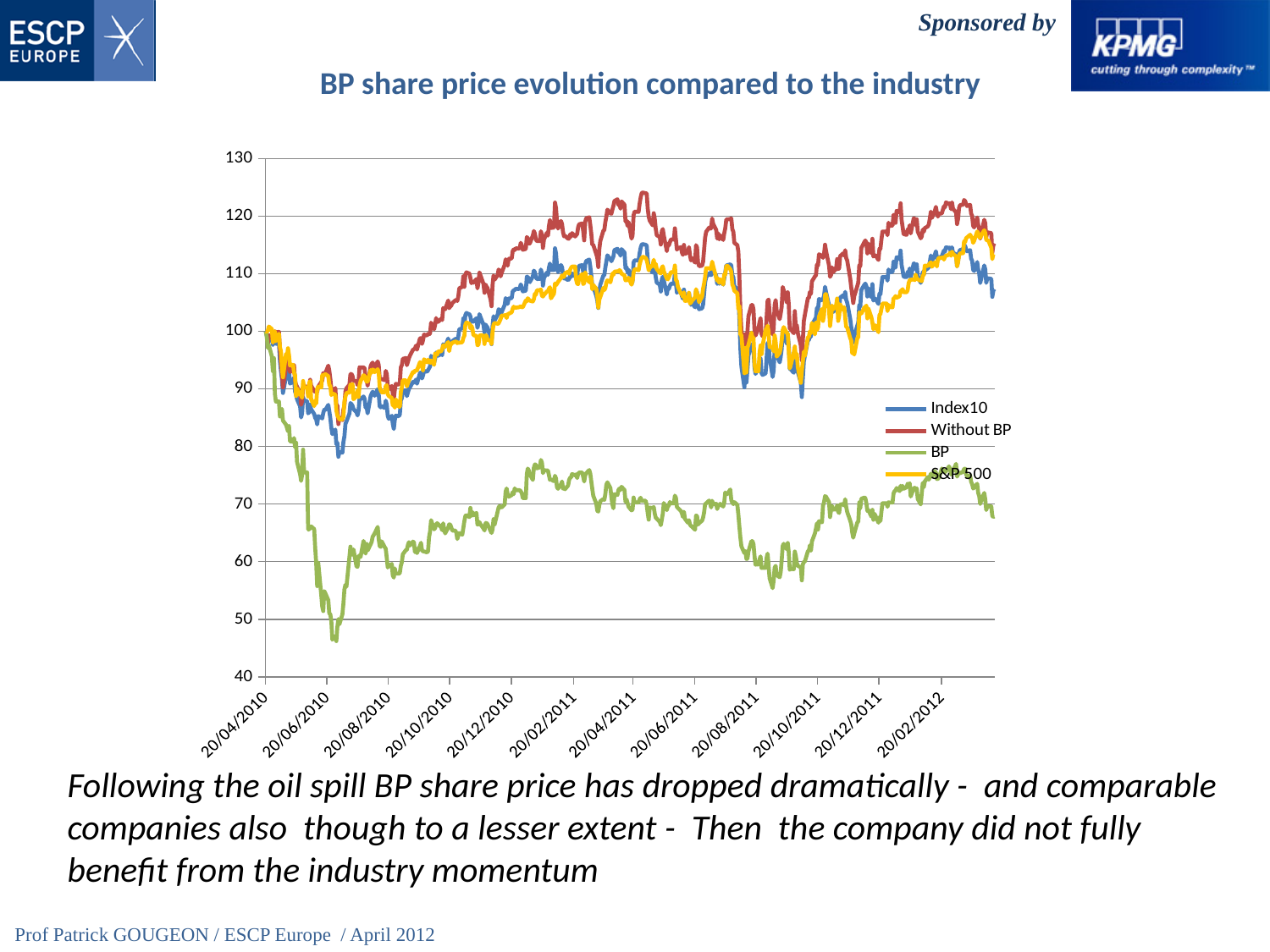
Does the BP series rise or fall between 20/04/2010 and 20/06/2010? fall How many date labels are shown on the x axis? 12 At 20/02/2012, which series is higher, Without BP or BP? Without BP Is the value of BP at 20/02/2012 greater or less than 80? less Which series has the lowest values across the chart? BP Is the value of Without BP at 20/02/2012 greater or less than 110? greater What are the series names listed in the legend? Index10, Without BP, BP, S&P 500 How many series does the legend list? 4 Which series reaches the highest value on the chart? Without BP What kind of chart is shown on the slide? line chart Is the lowest value reached by the BP series greater or less than 50? less What is the title of the chart? BP share price evolution compared to the industry